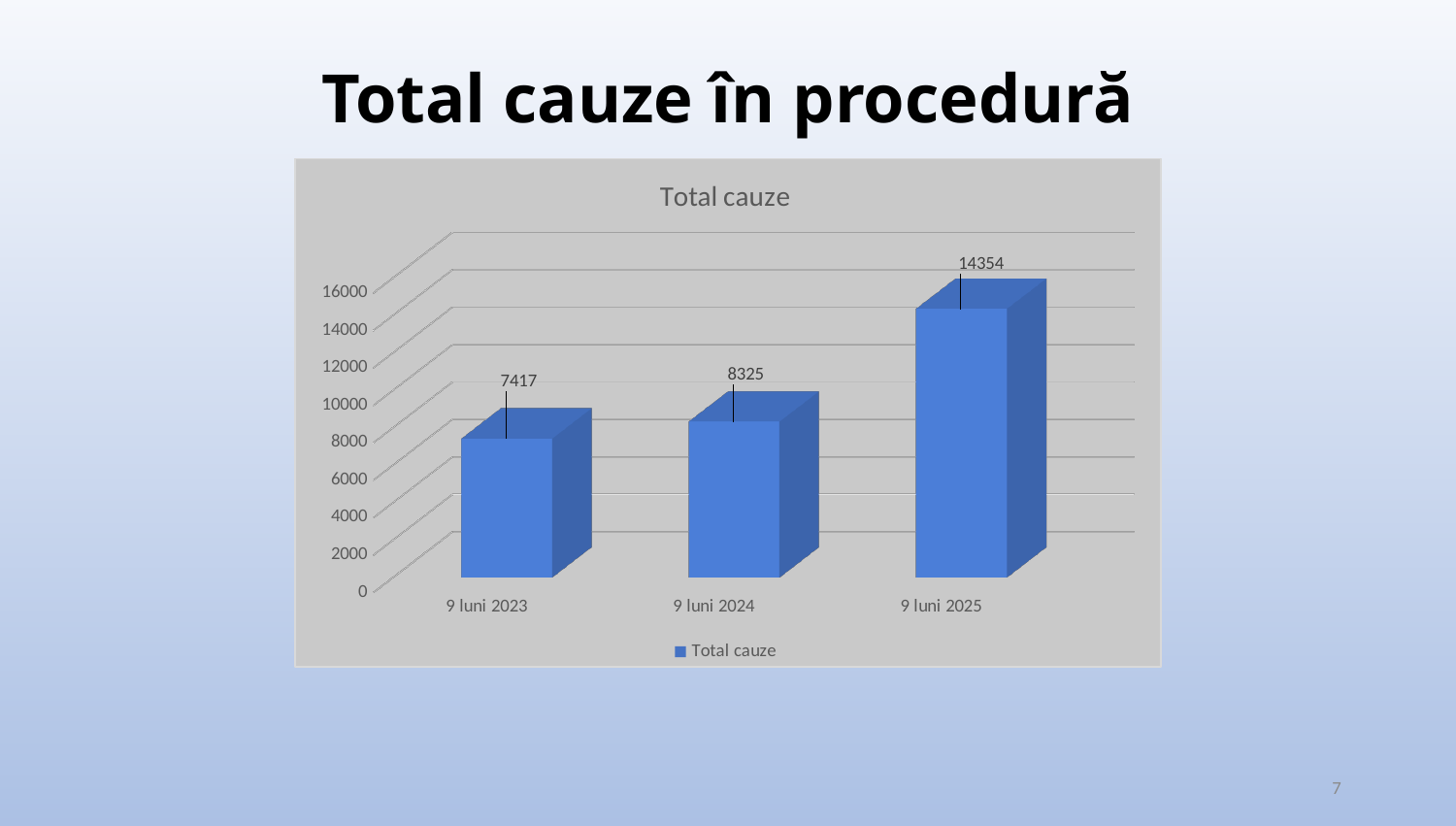
What is the value for 9 luni 2025? 14354 Which category has the highest value? 9 luni 2025 What is the value for 9 luni 2023? 7417 What is the difference between the values for 9 luni 2025 and 9 luni 2024? 6029 What kind of chart is shown? bar chart Which category has the lowest value? 9 luni 2023 Which is larger, the value for 9 luni 2024 or the value for 9 luni 2023? 9 luni 2024 How many categories are shown on the x axis? 3 What is the difference between the values for 9 luni 2024 and 9 luni 2023? 908 How many series does the legend list? 1 What is the value for 9 luni 2024? 8325 Do the values rise or fall from 9 luni 2023 to 9 luni 2025? rise